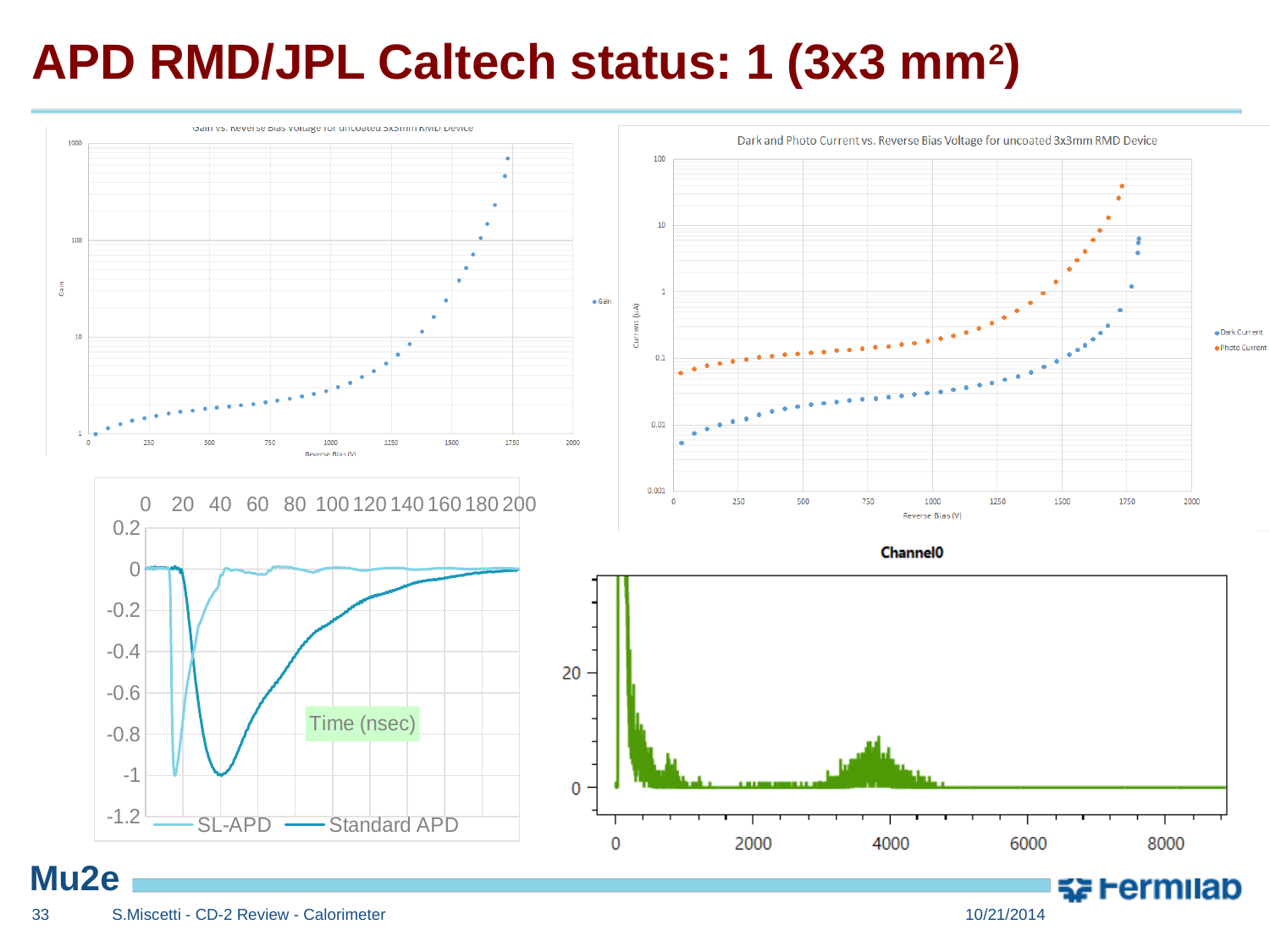
In the top-right chart, is the Photo Current at a reverse bias of 1500 V greater or less than 1? greater What is the title of the top-right chart? Dark and Photo Current vs. Reverse Bias Voltage for uncoated 3x3mm RMD Device In the top-left chart, is the gain at a reverse bias of 1500 V greater or less than 10? greater In the top-left chart (Gain vs. Reverse Bias Voltage), does the gain rise or fall as the reverse bias increases? rises In the bottom-left chart with the Time (nsec) axis, how many series does the legend list? 2 What is the title of the bottom-right chart? Channel0 In the bottom-left chart, is the minimum value of the Standard APD curve greater or less than -0.8? less In the top-right chart, which series has the higher current at a reverse bias of 1000 V, Dark Current or Photo Current? Photo Current In the bottom-left chart, which curve reaches its minimum earlier in time, SL-APD or Standard APD? SL-APD In the top-right chart (Dark and Photo Current vs. Reverse Bias Voltage), how many series does the legend list? 2